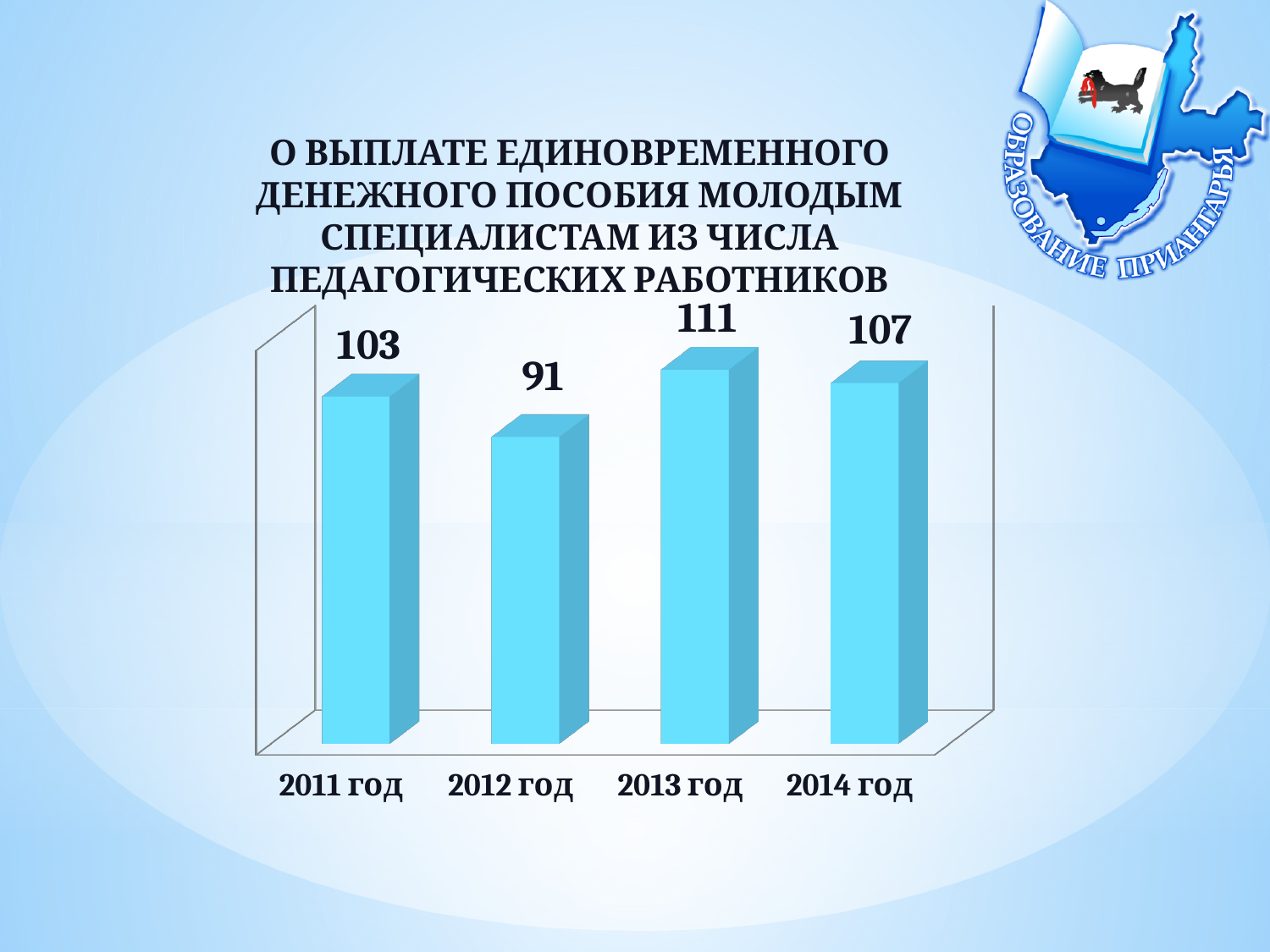
What kind of chart is shown on the slide? bar chart How many years are shown on the chart? 4 Which is larger, the value for 2011 год or the value for 2012 год? 2011 год Which year has the lowest value? 2012 год What is the value for 2012 год? 91 What is the difference between the values for 2014 год and 2011 год? 4 What is the difference between the values for 2013 год and 2012 год? 20 What is the value for 2014 год? 107 What is the value for 2011 год? 103 What is the value for 2013 год? 111 Which year has the highest value? 2013 год Does the value rise or fall from 2013 год to 2014 год? fall